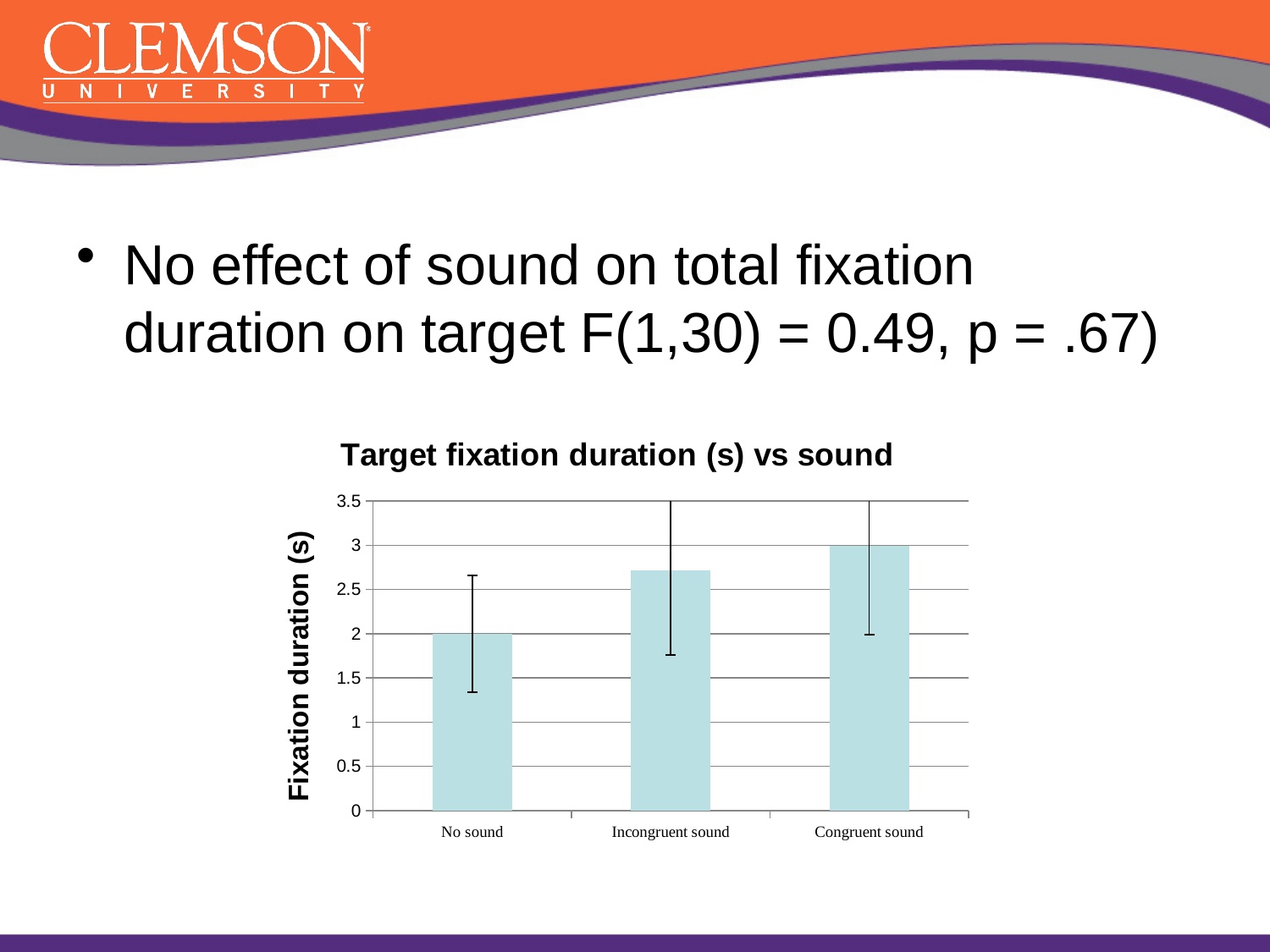
What kind of chart is shown on the slide? bar chart What is the label on the vertical axis of the chart? Fixation duration (s) What is the fixation duration for the No sound condition? 2 Which sound condition has the lowest target fixation duration? No sound Is the value for Incongruent sound greater or less than 2.5? greater How many sound conditions (categories) are plotted in the chart? 3 Is the value for No sound greater or less than 2.5? less Which sound condition has the highest target fixation duration? Congruent sound What is the title of the chart? Target fixation duration (s) vs sound Do the bar values rise or fall from left to right across the x axis? rise Which is larger, the fixation duration for Incongruent sound or for No sound? Incongruent sound